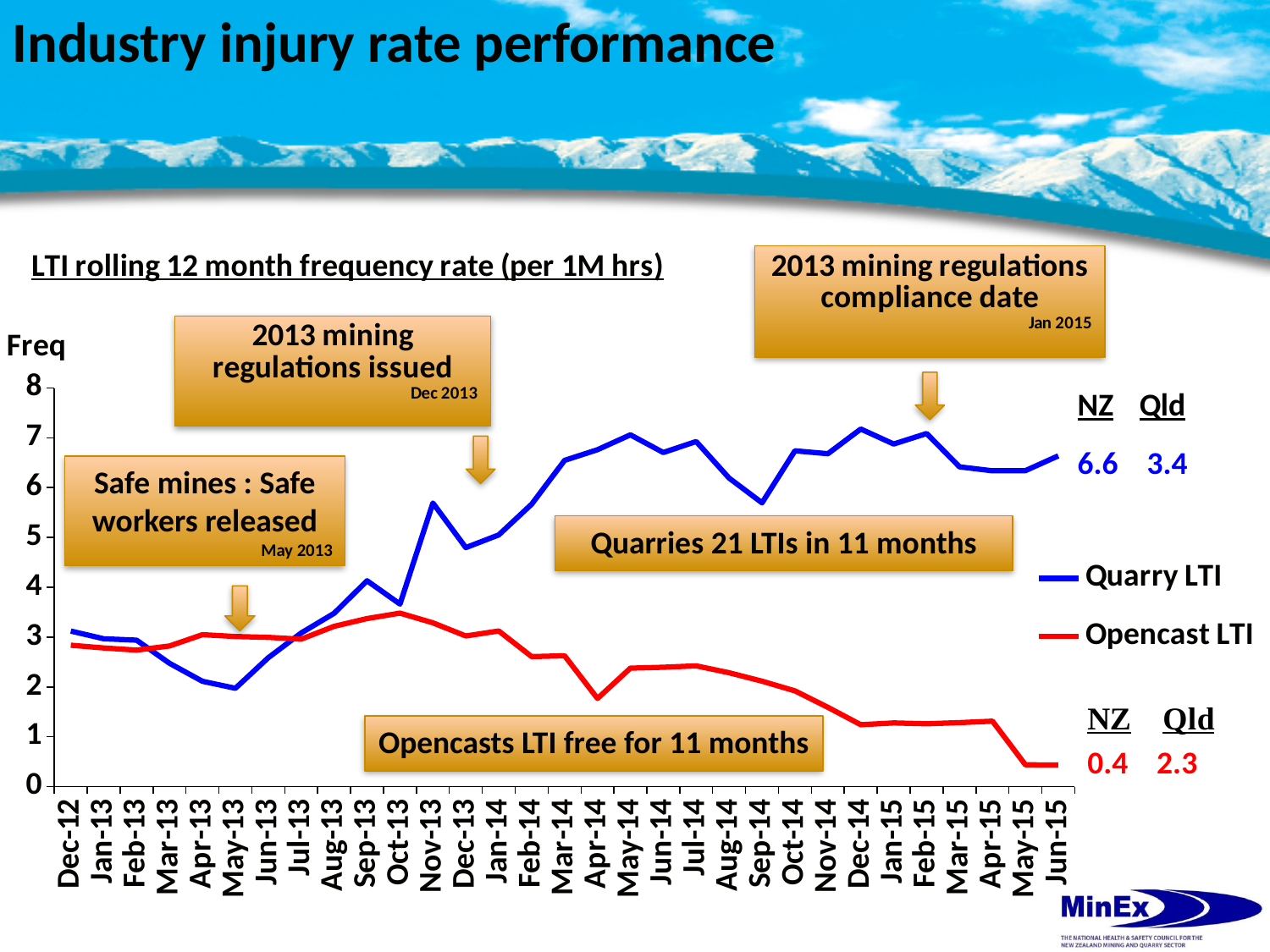
At Jun-15, which series has the higher value, Quarry LTI or Opencast LTI? Quarry LTI Is the Quarry LTI value for May-13 greater or less than 3? less Is the Opencast LTI value for Jun-15 greater or less than 1? less Is the Quarry LTI value for May-14 greater or less than 6? greater What are the two series named in the chart legend? Quarry LTI and Opencast LTI At May-13, which series has the higher value, Quarry LTI or Opencast LTI? Opencast LTI How many months are shown along the x axis, from Dec-12 to Jun-15? 31 Does the Opencast LTI line rise or fall between Oct-13 and Jun-15? Fall What is the title of the chart? LTI rolling 12 month frequency rate (per 1M hrs) What kind of chart is shown on the slide? Line chart How many series does the chart legend list? 2